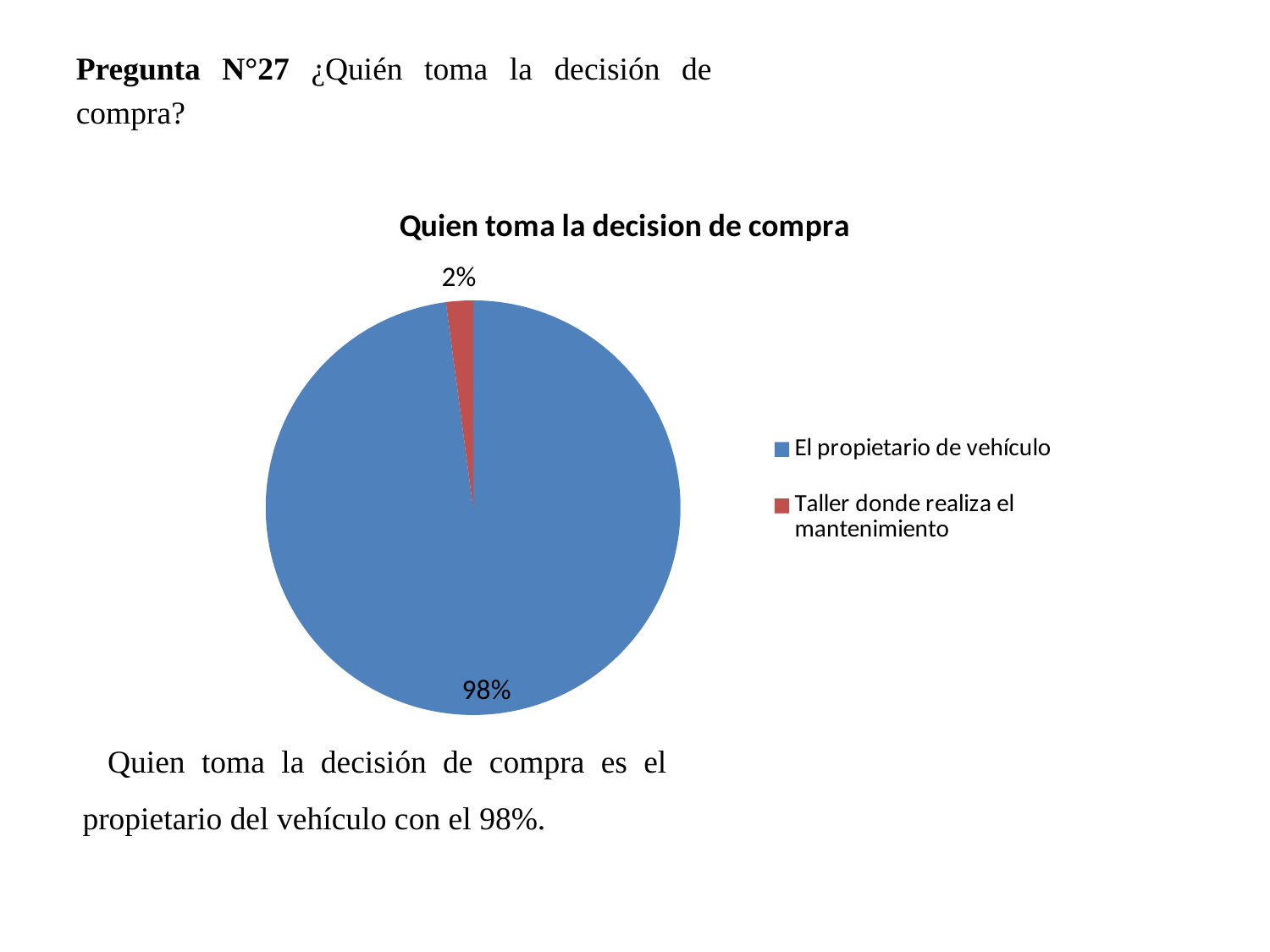
Which category has the smallest slice of the pie? Taller donde realiza el mantenimiento What is the title of the chart? Quien toma la decision de compra How many entries does the legend list? 2 What share of the pie does 'El propietario de vehículo' represent? 98% What kind of chart is shown on the slide? pie chart How many categories does the pie chart show? 2 What is the difference in percentage points between the 'El propietario de vehículo' slice and the 'Taller donde realiza el mantenimiento' slice? 96% Which category has the largest slice of the pie? El propietario de vehículo What share of the pie does 'Taller donde realiza el mantenimiento' represent? 2% Which is larger: the slice for 'El propietario de vehículo' or the slice for 'Taller donde realiza el mantenimiento'? El propietario de vehículo What colour is the slice for 'Taller donde realiza el mantenimiento'? red